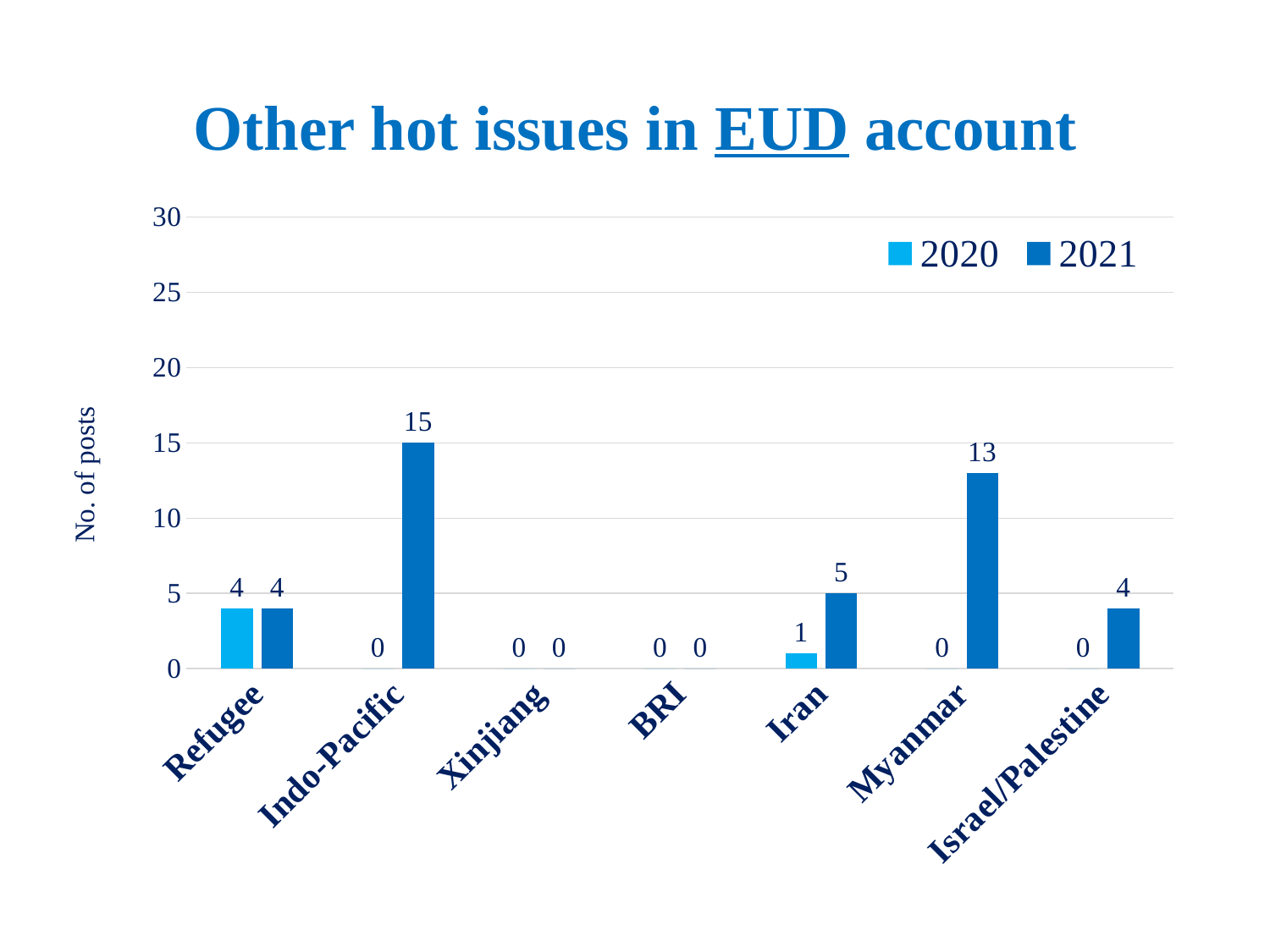
Which category has the highest value in 2021? Indo-Pacific Which category has the highest value in 2020? Refugee Which is larger, the 2021 value for Iran or the 2021 value for Israel/Palestine? Iran What is the title of the chart? Other hot issues in EUD account What is the difference between the 2021 values for Indo-Pacific and Myanmar? 2 How many series does the legend list? 2 What is the value for Indo-Pacific in 2021? 15 What is the value for Myanmar in 2021? 13 What is the value for Israel/Palestine in 2021? 4 How many categories are shown on the x axis? 7 What is the value for Iran in 2020? 1 What kind of chart is shown on the slide? Bar chart